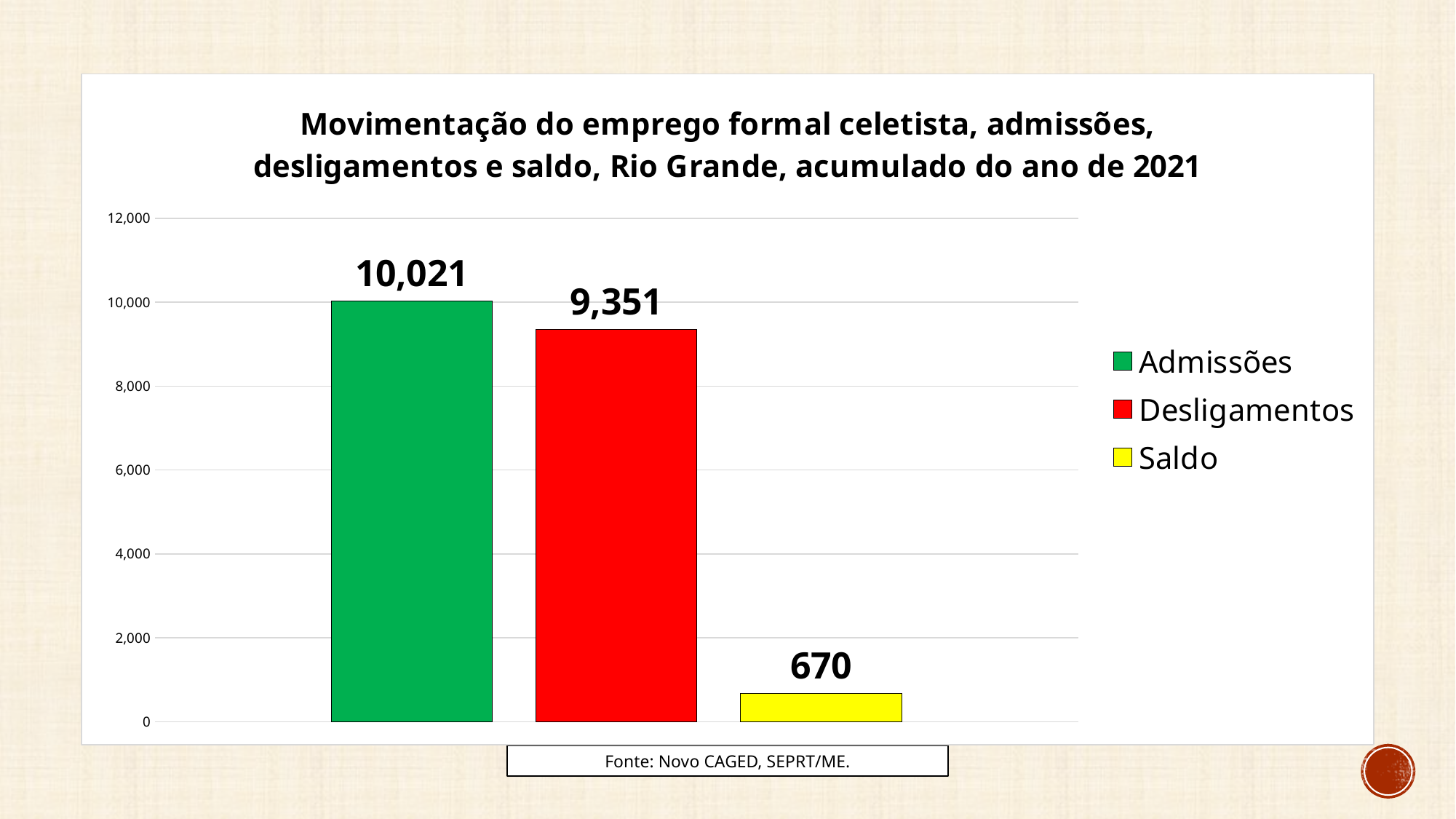
What is the value for Saldo? 670 How many bars are plotted in the chart? 3 Which series has the highest value? Admissões What is the value for Desligamentos? 9,351 What is the difference between Admissões and Desligamentos? 670 How many series does the legend list? 3 What colour is the bar for Saldo? yellow Is the value for Desligamentos greater or less than 10,000? less What kind of chart is shown on the slide? bar chart Which series has the lowest value? Saldo What is the value for Admissões? 10,021 Which is larger, Admissões or Desligamentos? Admissões